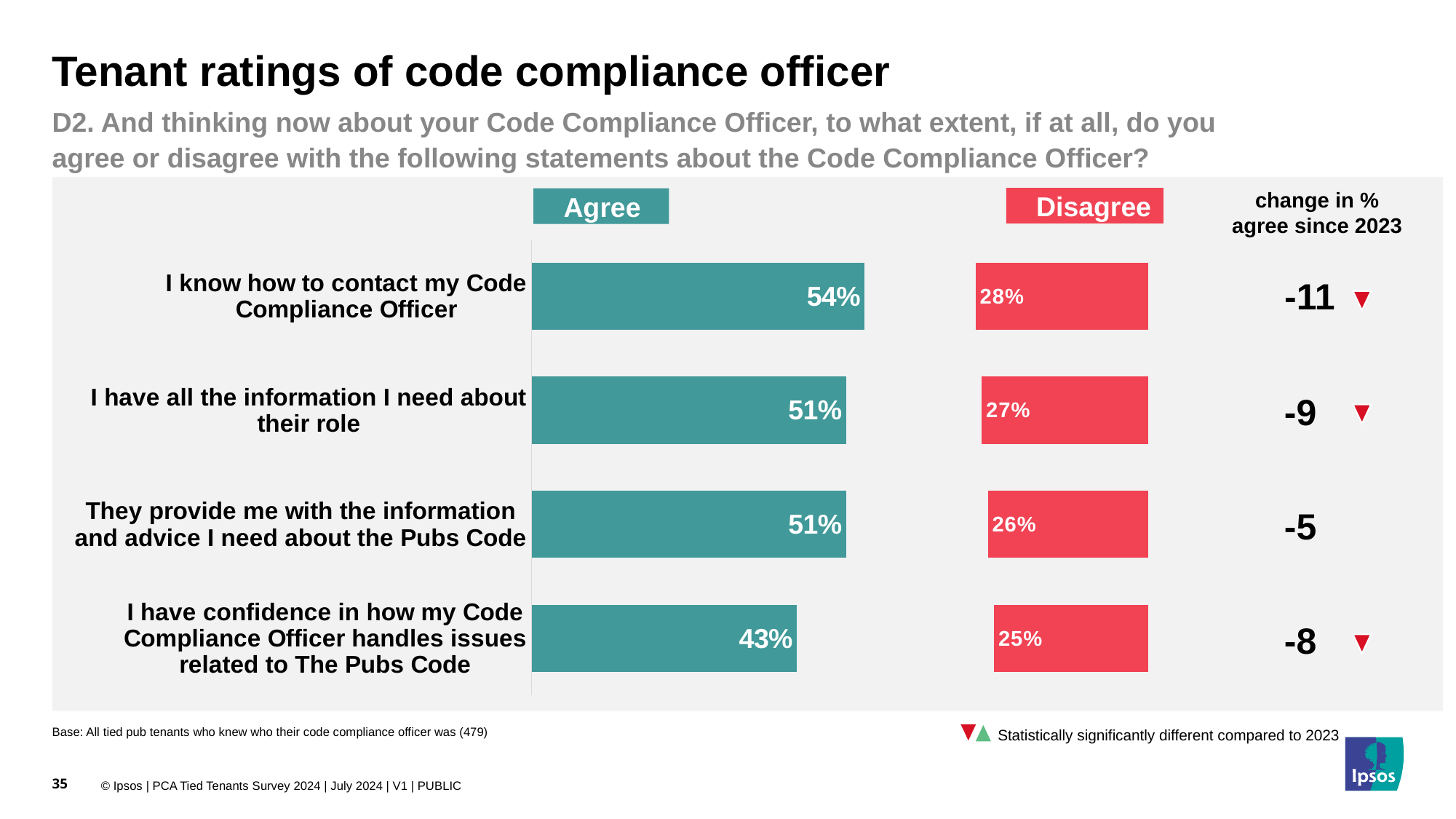
What is the difference between the Agree and Disagree percentages for 'I know how to contact my Code Compliance Officer'? 26 percentage points Is the Agree percentage for 'They provide me with the information and advice I need about the Pubs Code' larger than its Disagree percentage? Yes, 51% vs 26% Which statement has the lowest Agree percentage? I have confidence in how my Code Compliance Officer handles issues related to The Pubs Code What is the difference in Agree percentage between 'I have all the information I need about their role' and 'I have confidence in how my Code Compliance Officer handles issues related to The Pubs Code'? 8 percentage points What is the change in % agree since 2023 for 'I know how to contact my Code Compliance Officer'? -11 How many statements are shown in the chart? 4 Which statement has the highest Disagree percentage? I know how to contact my Code Compliance Officer What type of chart is used on this slide? Bar chart What percentage of tenants agree that they know how to contact their Code Compliance Officer? 54% What percentage of tenants disagree that they have confidence in how their Code Compliance Officer handles issues related to The Pubs Code? 25% What is the Agree value for 'I have all the information I need about their role'? 51% Which statement has the highest Agree percentage? I know how to contact my Code Compliance Officer